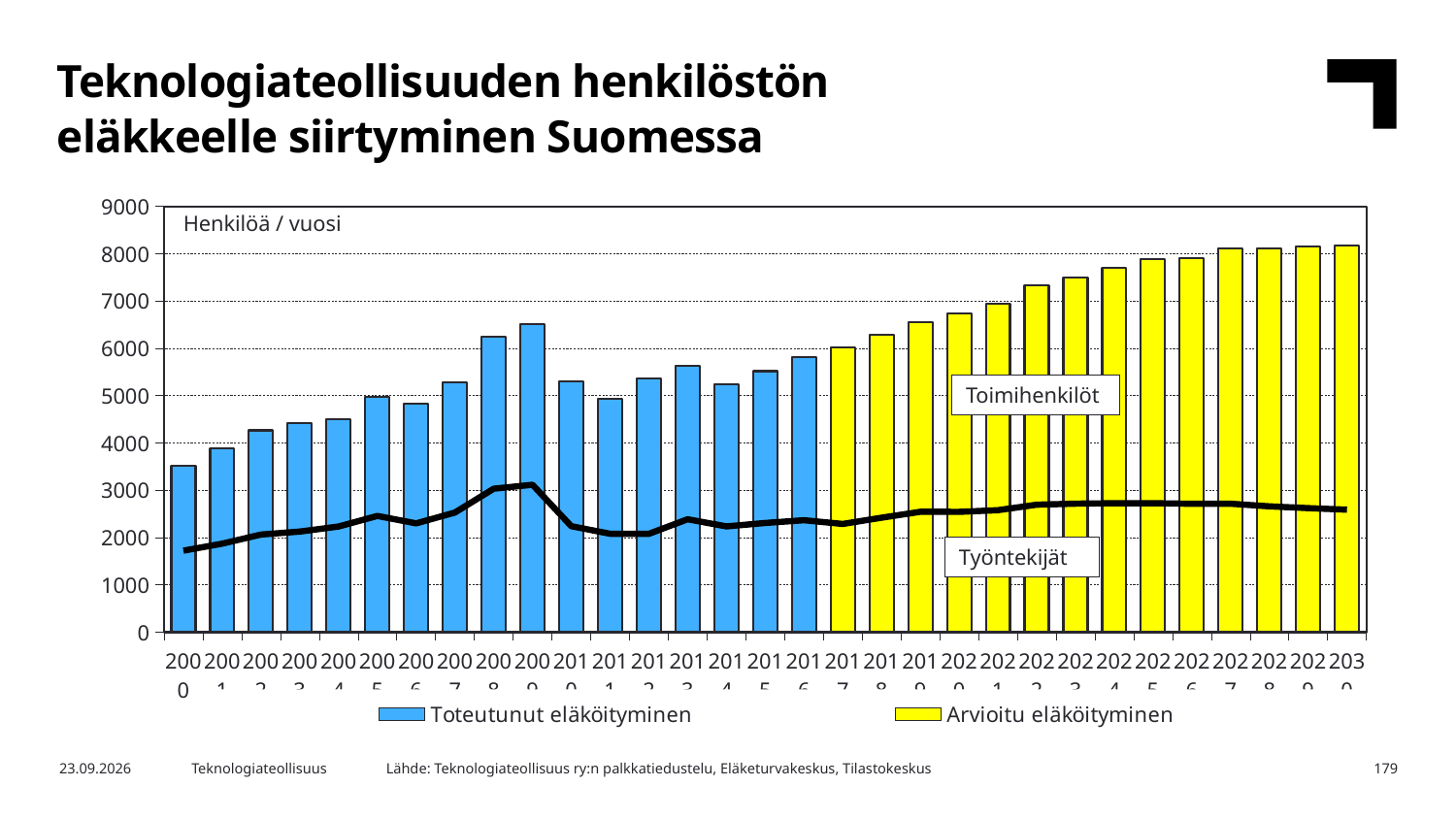
What unit label is shown at the top left of the plot area? Henkilöä / vuosi Which bar is taller, 2009 or 2010? 2009 Which year has the lowest bar? 2000 How many series does the legend list? 2 Is the bar for 2030 greater or less than 8000? greater Is the bar for 2009 greater or less than 6000? greater Is the bar for 2000 greater or less than 4000? less Do the estimated (Arvioitu eläköityminen) bars rise or fall from 2017 to 2030? rise How many years are shown on the x axis? 31 What are the two legend entries? Toteutunut eläköityminen and Arvioitu eläköityminen What kind of chart is shown on the slide? Combination bar and line chart